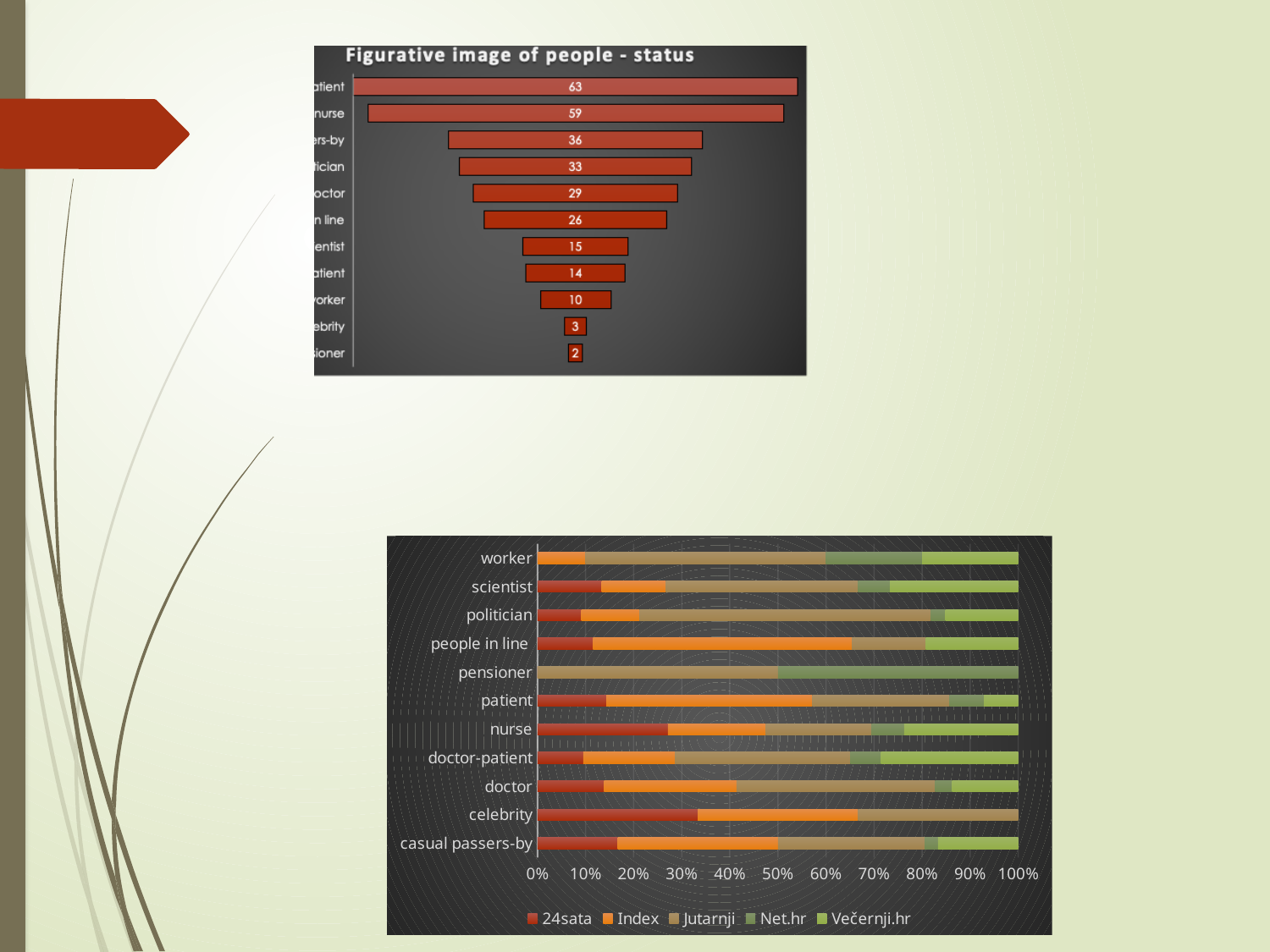
What type of chart is the bottom chart? stacked bar chart In the bottom chart, which category has the largest 24sata share, celebrity or worker? celebrity In the bottom chart, is the 24sata share for worker greater or less than 20%? less How many series does the legend of the bottom chart list? 5 In the top chart 'Figurative image of people - status', what is the difference between the two largest values, 63 and 59? 4 In the top chart 'Figurative image of people - status', what is the lowest value shown? 2 In the bottom chart, which series is listed last in the legend? Večernji.hr What type of chart is the top chart titled 'Figurative image of people - status'? bar chart How many bars are shown in the top chart 'Figurative image of people - status'? 11 How many categories are shown on the bottom chart? 11 In the top chart 'Figurative image of people - status', what is the value for nurse? 59 In the top chart 'Figurative image of people - status', what is the highest value shown? 63